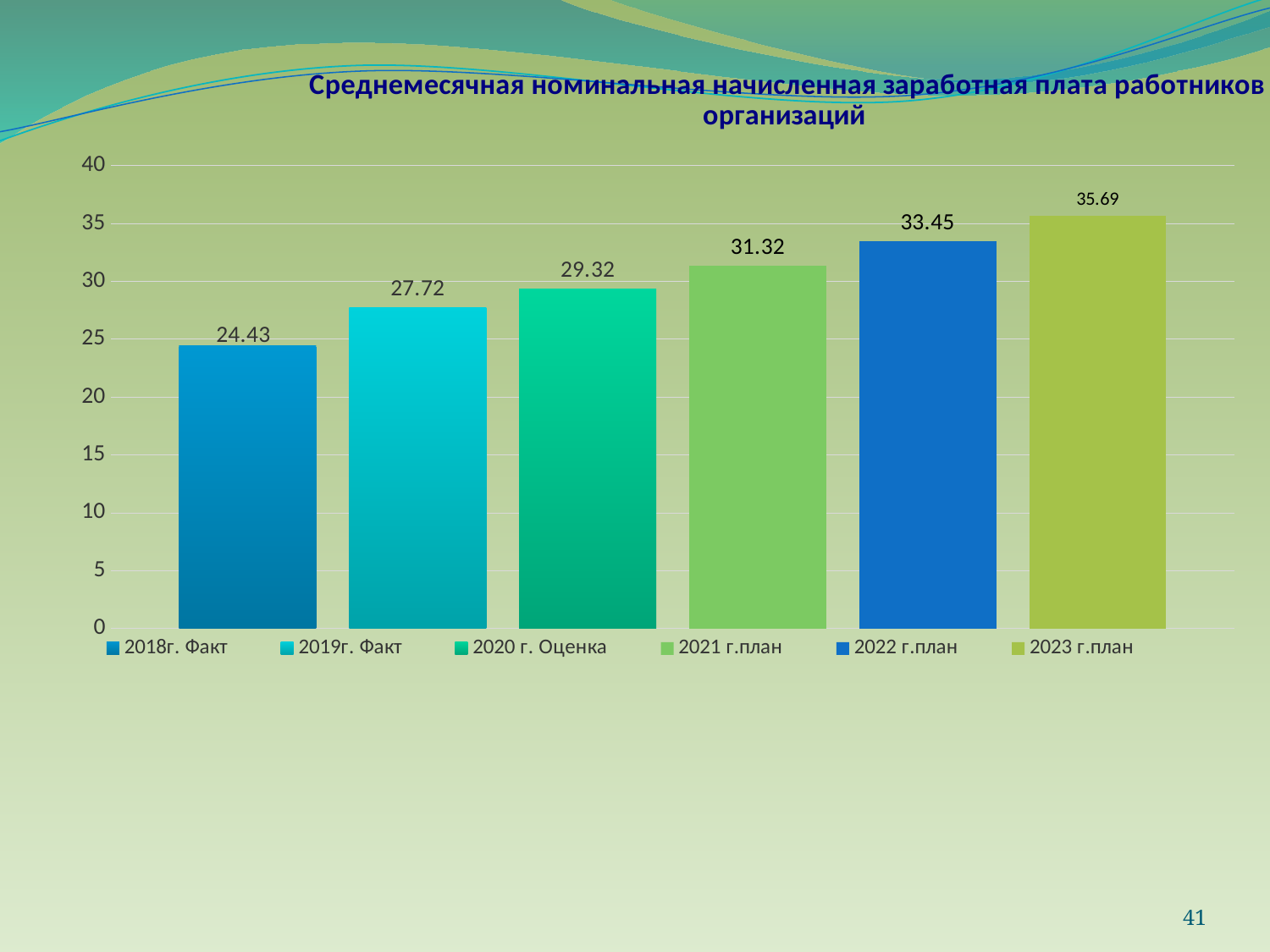
What is the difference between the values for 2022 г.план and 2021 г.план? 2.13 Which is larger, the value for 2020 г. Оценка or the value for 2022 г.план? 2022 г.план What is the difference between the values for 2019г. Факт and 2018г. Факт? 3.29 How many series does the legend list? 6 Which series has the highest value? 2023 г.план What is the value for 2018г. Факт? 24.43 What is the value for 2020 г. Оценка? 29.32 Is the value for 2021 г.план greater or less than 30? greater What is the value for 2023 г.план? 35.69 What kind of chart is shown on the slide? bar chart Do the values rise or fall from 2018г. Факт to 2023 г.план? rise Which series has the lowest value? 2018г. Факт